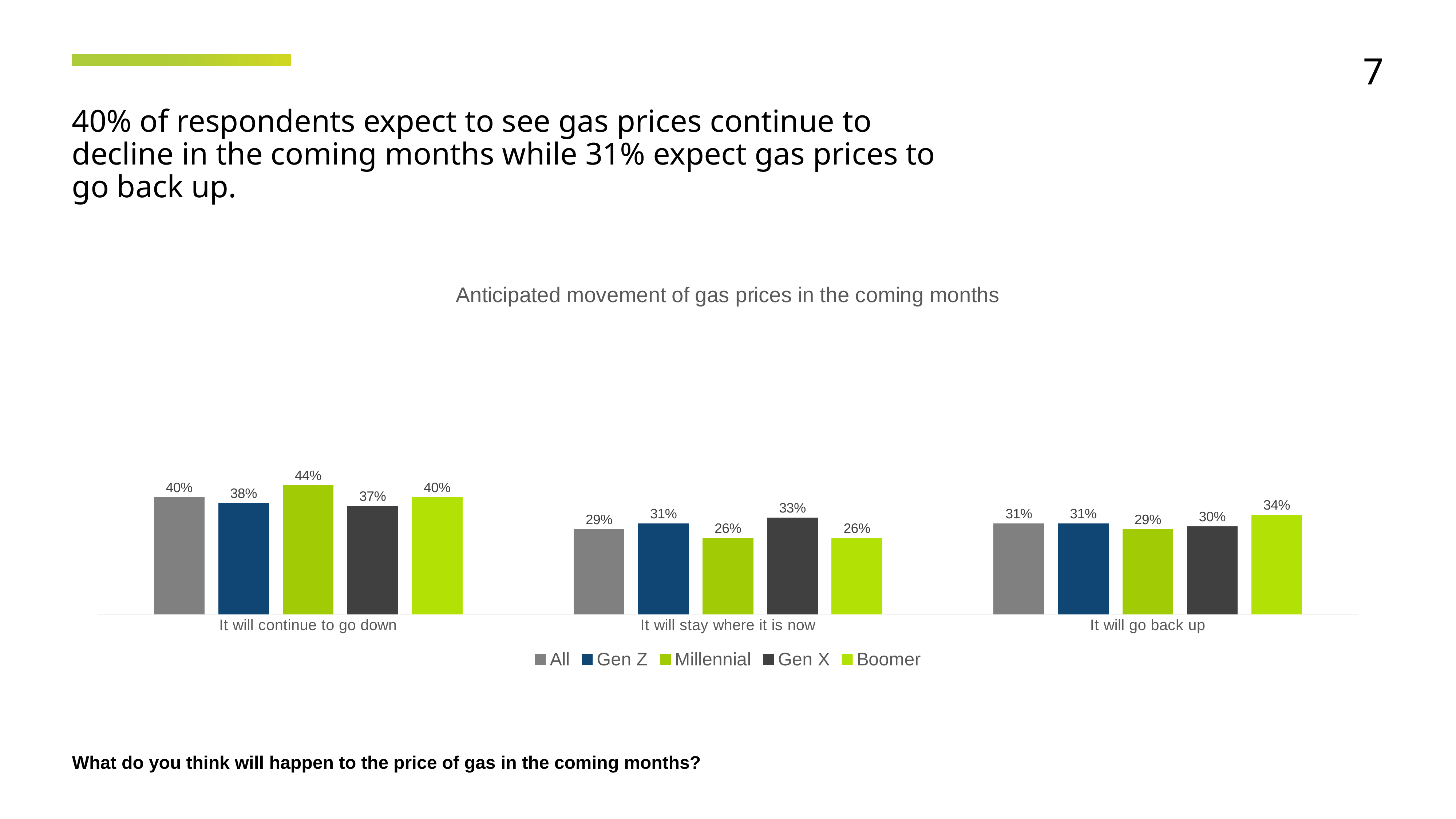
What is the difference between the Millennial and Gen X values in the 'It will continue to go down' category? 7% What is the value for Millennial in the 'It will continue to go down' category? 44% Which series has the highest value in the 'It will continue to go down' category? Millennial How many series does the legend list? 5 What is the value for All in the 'It will stay where it is now' category? 29% What kind of chart is shown on the slide? Bar chart What is the title of the chart? Anticipated movement of gas prices in the coming months What is the value for Gen X in the 'It will stay where it is now' category? 33% How many categories are shown on the x axis? 3 Which series has the lowest value in the 'It will continue to go down' category? Gen X What is the value for Boomer in the 'It will go back up' category? 34% Which is larger in the 'It will go back up' category: the Boomer value or the Millennial value? Boomer